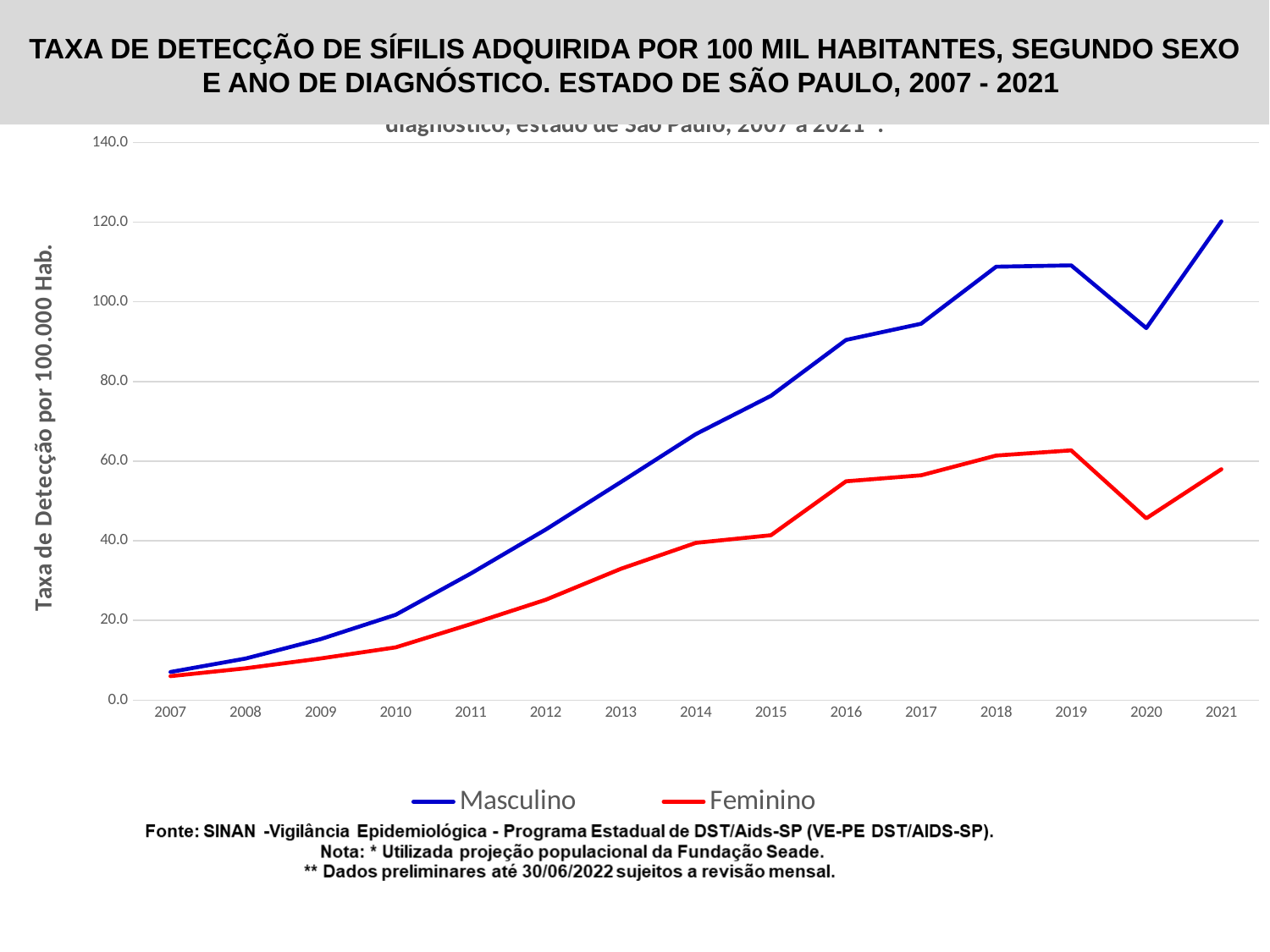
Is the Masculino value for 2020 greater or less than 100? less In which year is the Masculino rate highest? 2021 How many years are plotted along the x axis? 15 Is the Feminino value for 2020 greater or less than 40? greater In which year is the Feminino rate lowest? 2007 What kind of chart is shown on the slide? line chart How many series does the legend list? 2 Is the Masculino value for 2018 greater or less than 100? greater In which year is the Masculino rate lowest? 2007 What colour is the Feminino line? red Which series has the higher value in 2021, Masculino or Feminino? Masculino Do the Masculino values generally rise or fall from 2007 to 2019? rise